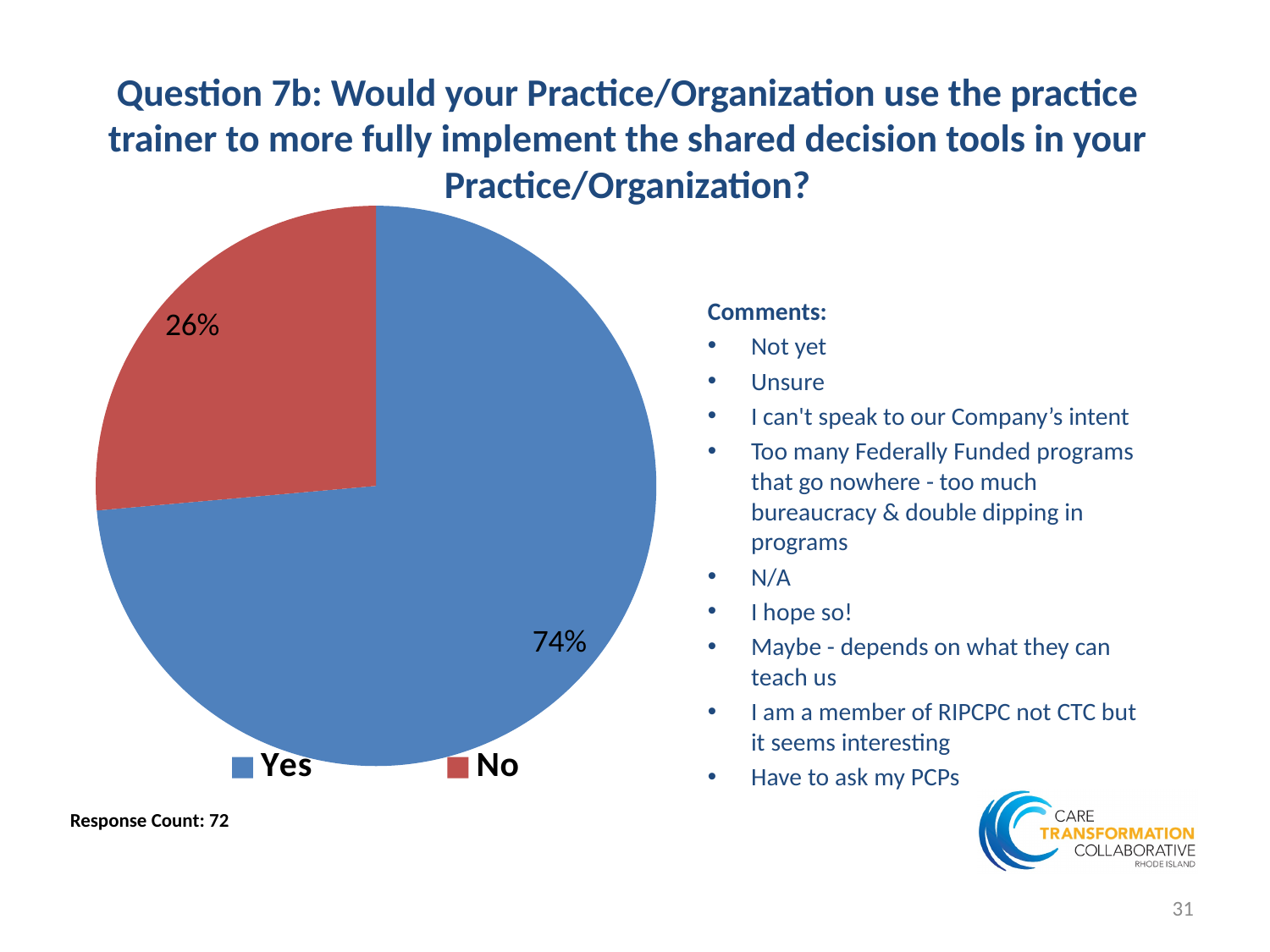
Which is larger, the share for "Yes" or the share for "No"? Yes Which response has the largest share of the pie? Yes What colour is the "Yes" slice in the pie chart? Blue What share of the pie does the "No" slice represent? 26% What is the response count shown below the chart? 72 What kind of chart is shown on the slide? Pie chart How many slices does the pie chart have? 2 What percentage of responses were "Yes"? 74% Which response has the smallest share of the pie? No What is the difference in percentage points between the "Yes" and "No" shares? 48 How many entries does the legend list? 2 What percentage of responses were "No"? 26%